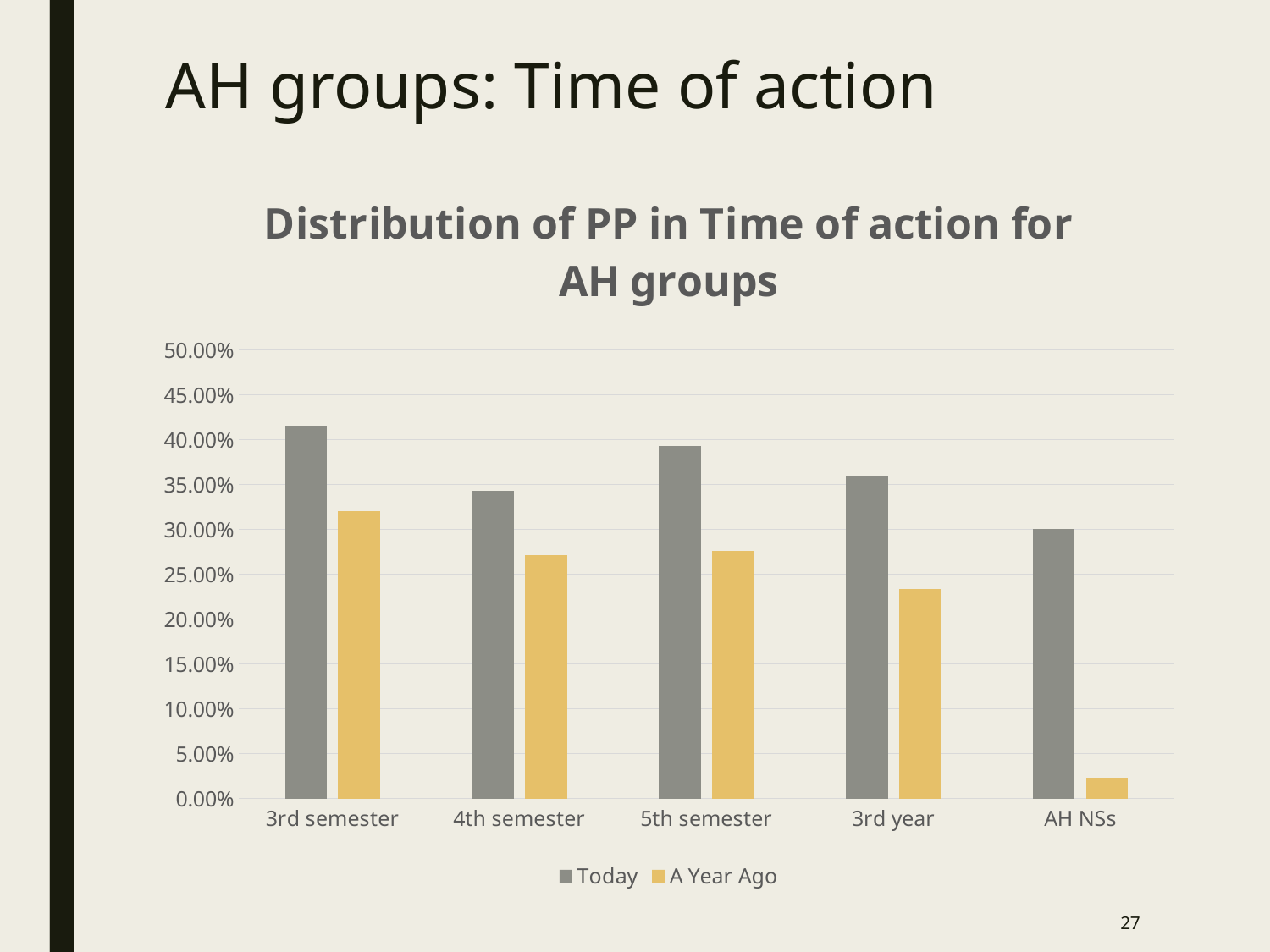
Which category has the highest value for the Today series? 3rd semester What type of chart is shown on the slide? bar chart Is the A Year Ago value for AH NSs greater or less than 5.00%? less Is the A Year Ago value for 3rd year greater or less than 25.00%? less What is the title of the chart? Distribution of PP in Time of action for AH groups How many series does the legend list? 2 Which category has the lowest value for the A Year Ago series? AH NSs For the Today series, which is larger: 5th semester or 3rd year? 5th semester Which category has the lowest value for the Today series? AH NSs How many categories are shown on the x axis? 5 Which category has the highest value for the A Year Ago series? 3rd semester Is the Today value for 3rd semester greater or less than 40.00%? greater